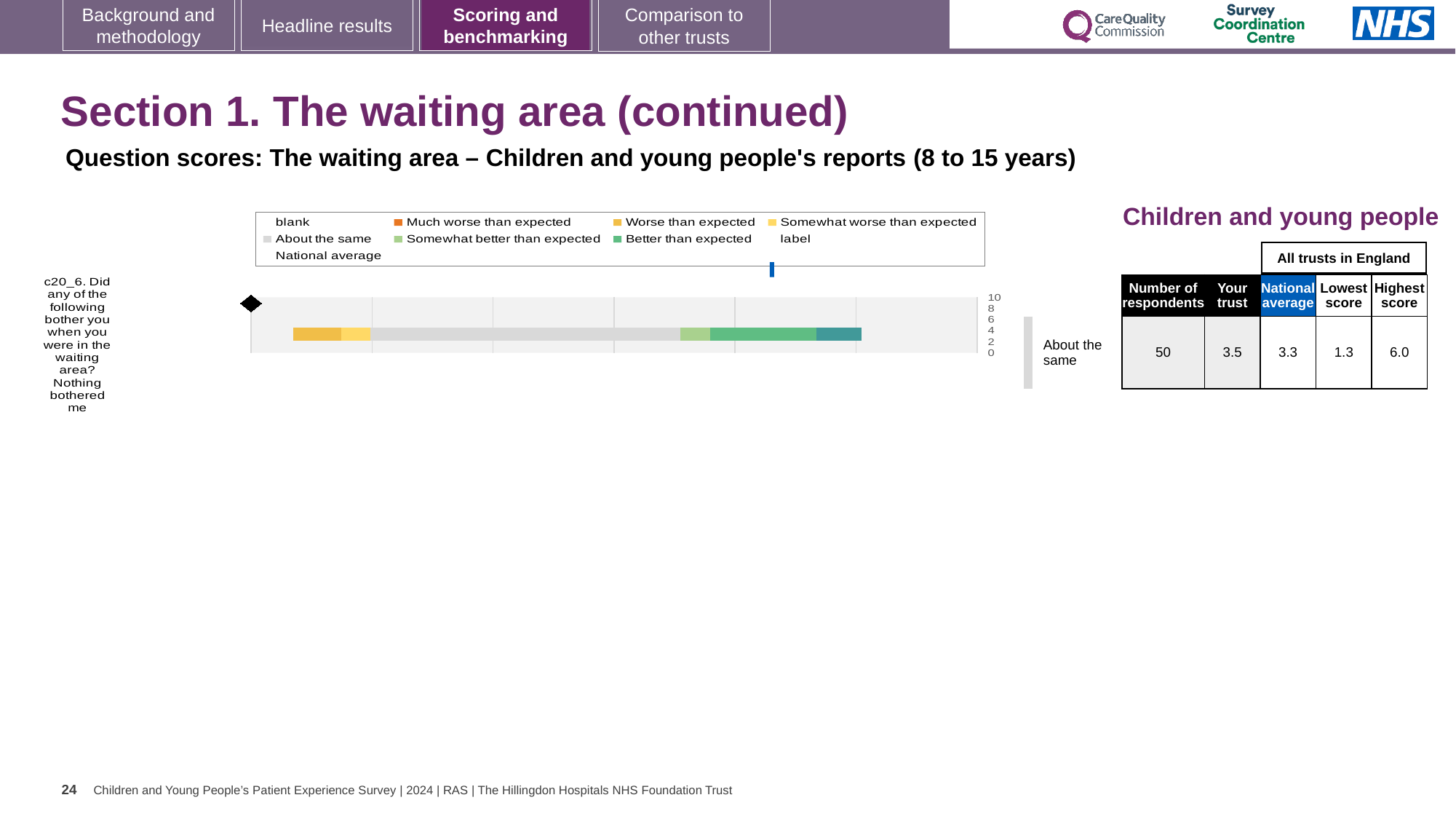
In the table next to the chart, what is the score for Your trust? 3.5 What benchmark category label is shown to the right of the bar for question c20_6? About the same What is the highest tick value shown on the chart's axis? 10 In the table next to the chart, what is the Lowest score across all trusts in England? 1.3 How many survey questions are plotted in the chart? 1 In the table next to the chart, what is the Highest score across all trusts in England? 6.0 How many entries does the chart legend list? 9 Which legend entry is shown in orange? Much worse than expected In the table next to the chart, which is larger: Your trust score or the National average? Your trust In the table next to the chart, what is the National average score? 3.3 What kind of chart is shown on the slide? bar chart In the table next to the chart, what is the number of respondents for question c20_6? 50